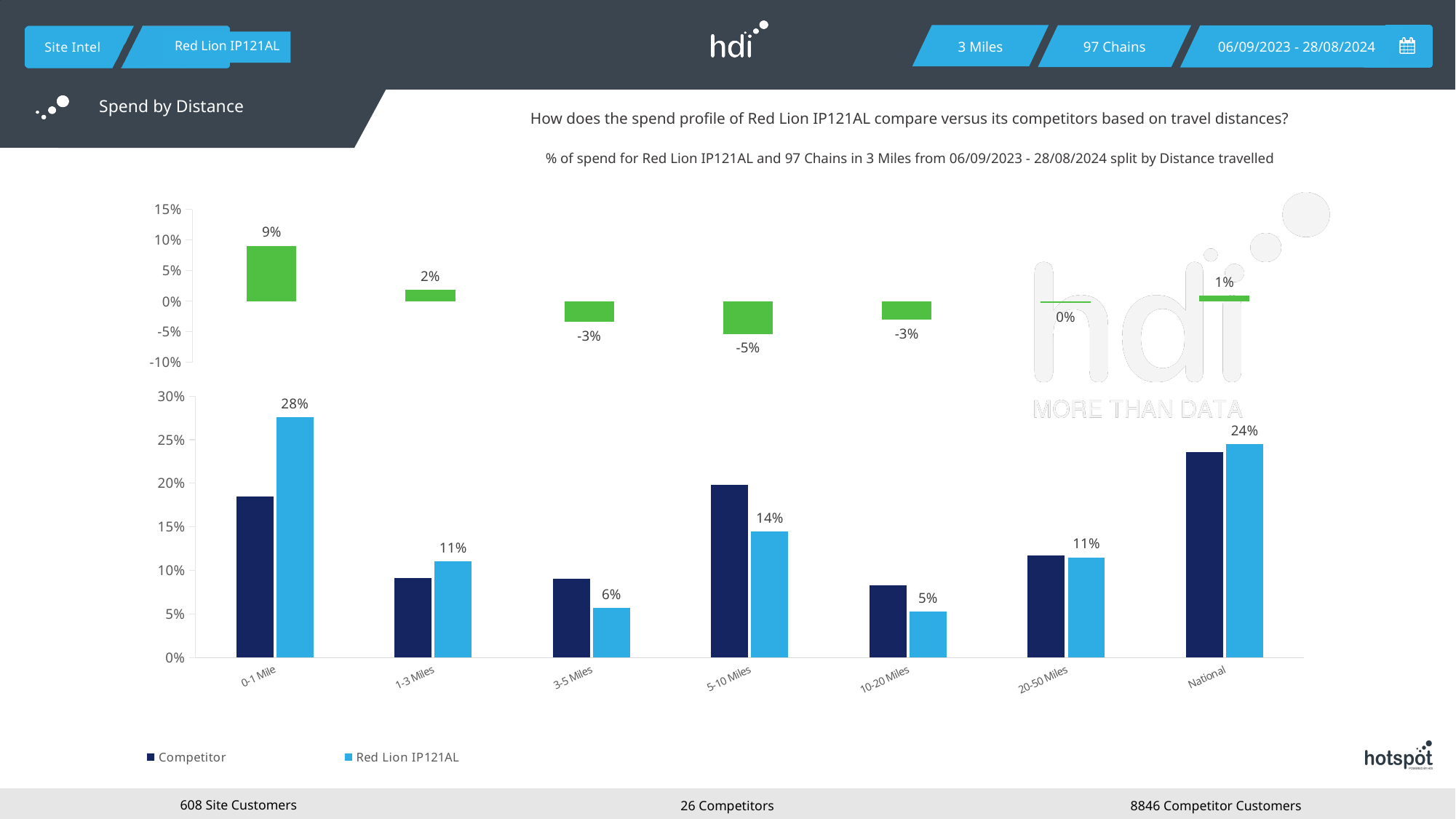
How many distance categories are shown on the x axis of the lower bar chart? 7 How many series does the legend of the lower bar chart list? 2 In the lower bar chart, what is the difference between the Red Lion IP121AL values for 0-1 Mile and National? 4% In the lower bar chart, is the Competitor value for 0-1 Mile greater or less than 15%? greater In the lower bar chart, is the Competitor value for 10-20 Miles greater or less than 10%? less In the lower bar chart, which series has the larger value in the 5-10 Miles category, Competitor or Red Lion IP121AL? Competitor In the upper chart with green bars, what is the lowest value shown? -5% In the lower bar chart, which series has the larger value in the 0-1 Mile category, Competitor or Red Lion IP121AL? Red Lion IP121AL In the lower bar chart, which category has the highest value for Red Lion IP121AL? 0-1 Mile In the lower bar chart, what is the value for Red Lion IP121AL in the 5-10 Miles category? 14% In the lower bar chart, what is the value for Red Lion IP121AL in the 0-1 Mile category? 28% In the lower bar chart, which category has the lowest value for Red Lion IP121AL? 10-20 Miles